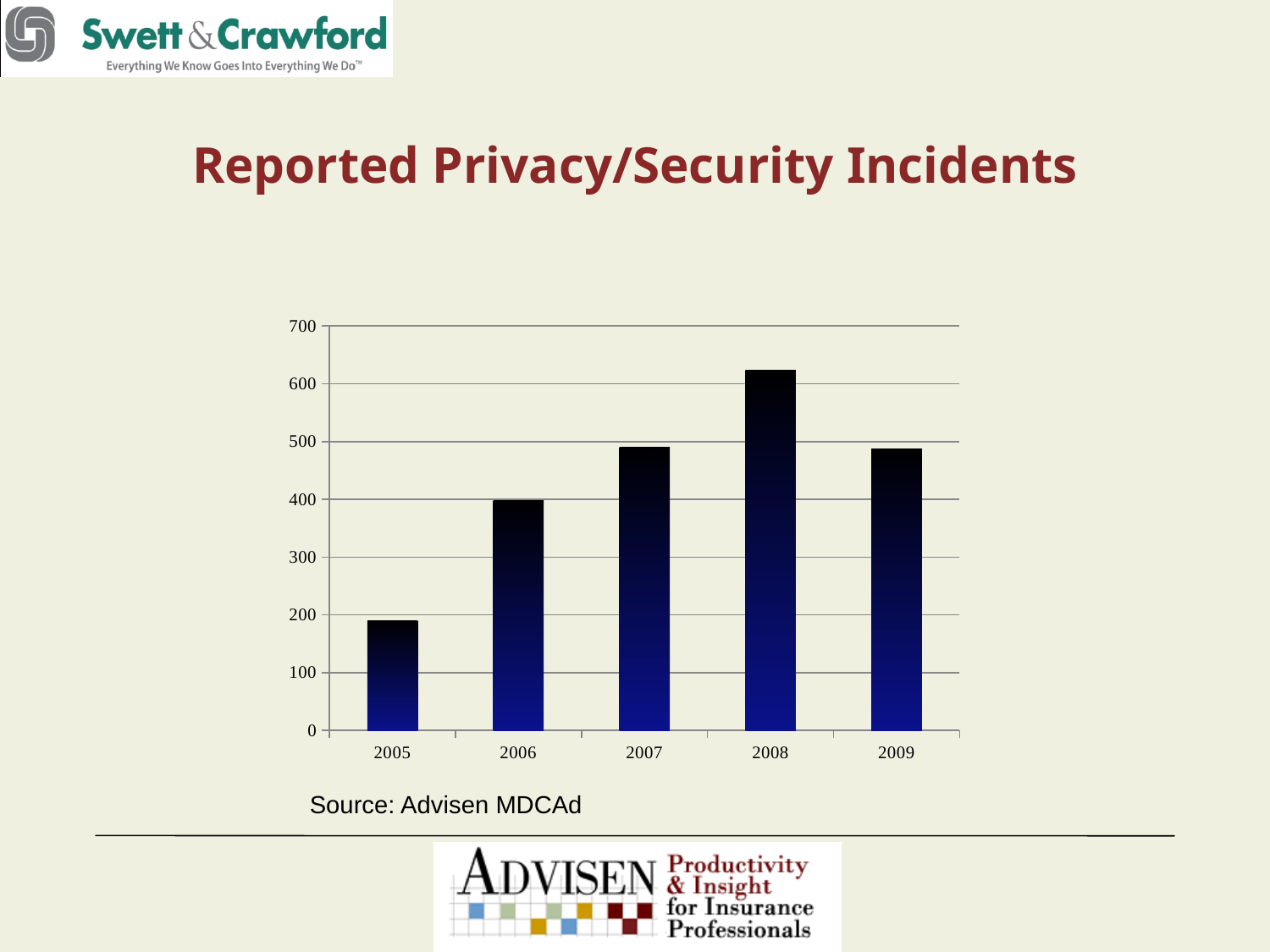
Is the value for 2008 greater or less than 600? greater Which year has the lowest number of reported privacy/security incidents? 2005 How many years are shown on the x axis of the chart? 5 What is the title of the chart on the slide? Reported Privacy/Security Incidents Which year has the larger value, 2005 or 2007? 2007 Is the value for 2009 greater or less than 500? less Is the value for 2006 greater or less than 300? greater Which year has the highest number of reported privacy/security incidents? 2008 What source is cited below the chart? Advisen MDCAd What kind of chart is shown on the slide? bar chart Which year has the larger value, 2006 or 2008? 2008